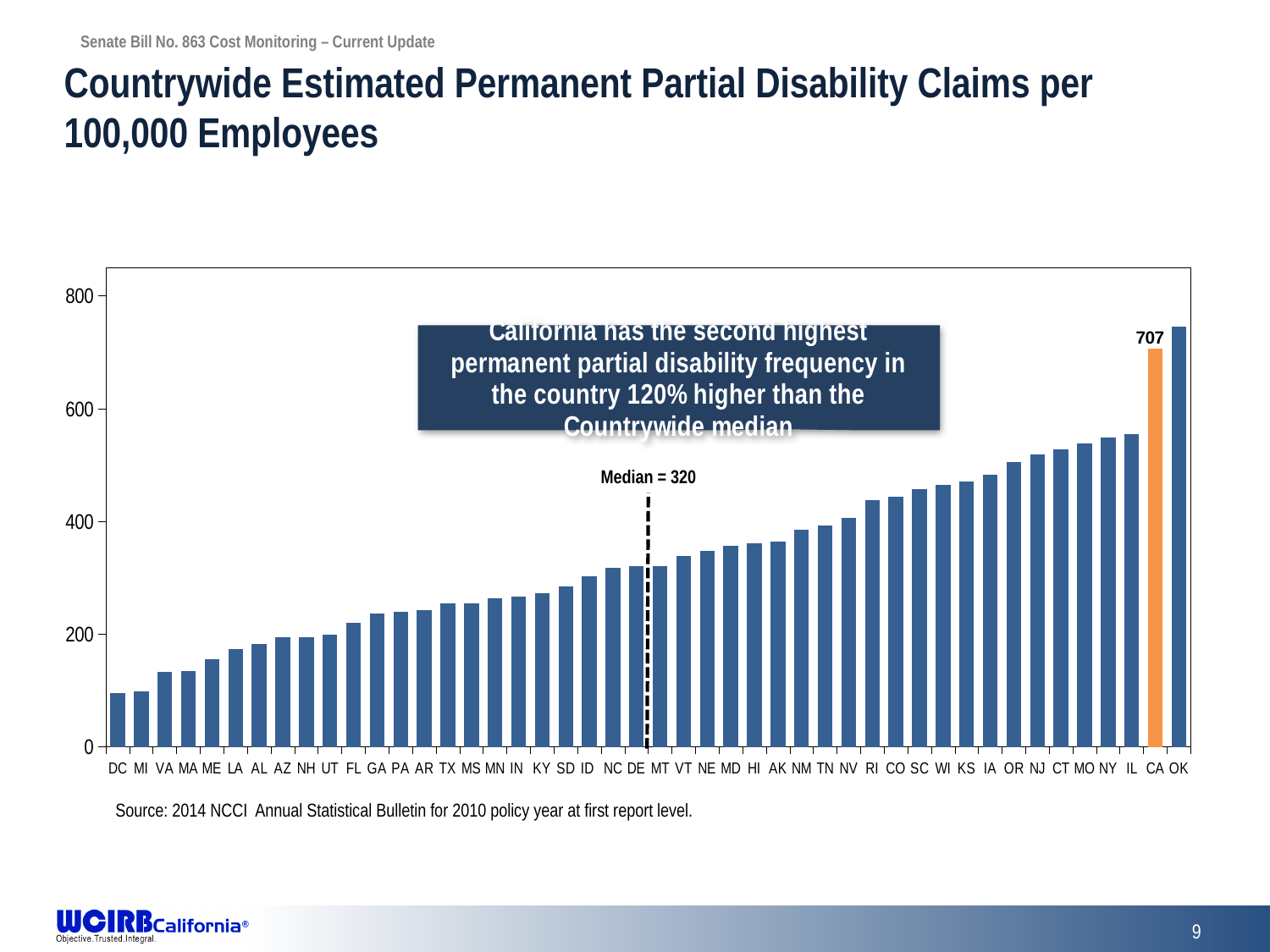
What countrywide median value is annotated on the chart? Median = 320 What type of chart is shown on the slide? bar chart Which state has the lowest value? DC Is the value for IL greater or less than 600? less Is the value for TX greater or less than 200? greater Which is larger, the value for CA or the value for IL? CA Which state has the highest value? OK Is the value for RI greater or less than 400? greater What is the value for CA (California)? 707 Do the values rise or fall moving from left to right along the x axis? rise